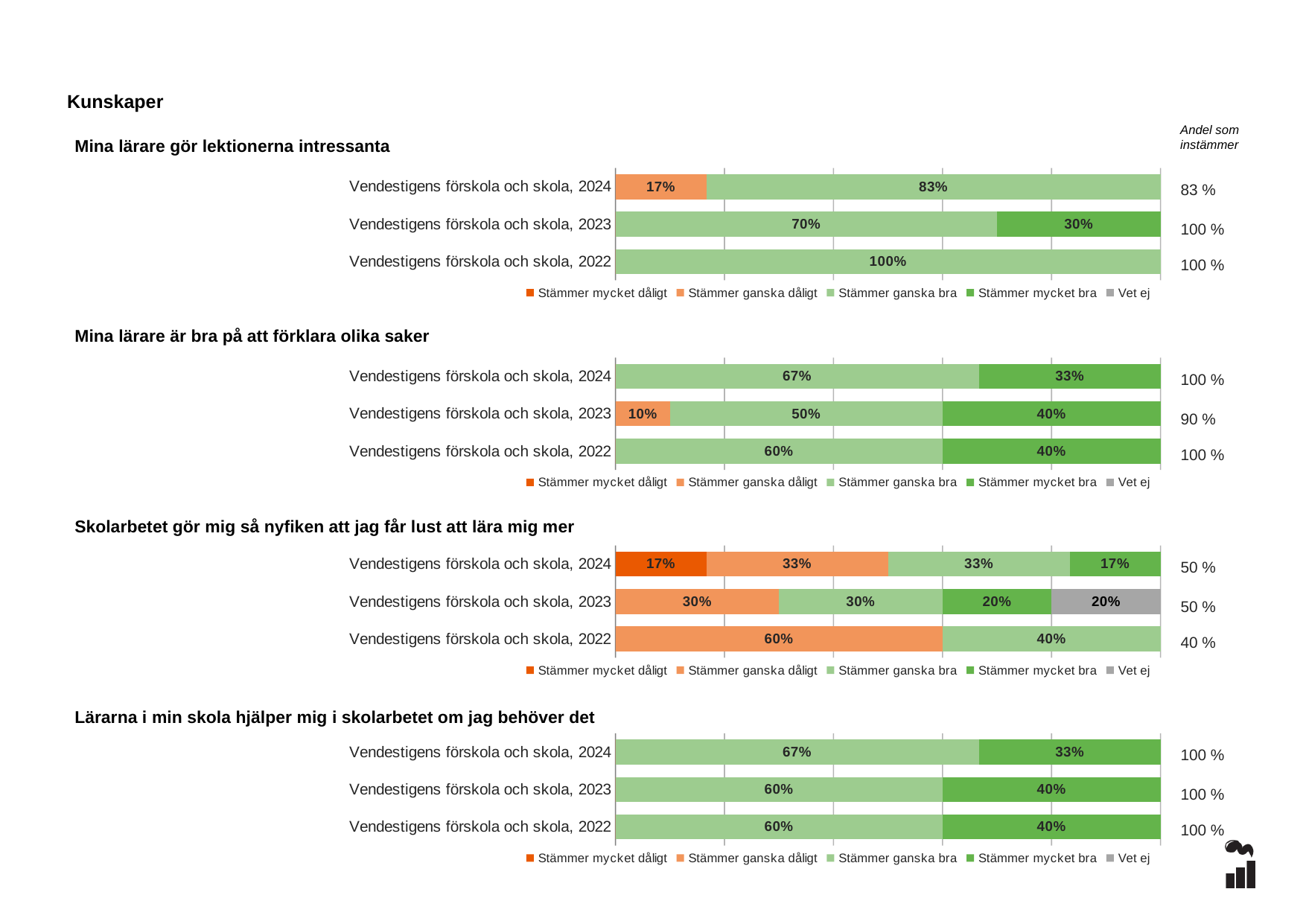
In the chart 'Skolarbetet gör mig så nyfiken att jag får lust att lära mig mer', what is the total of 'Stämmer ganska bra' and 'Stämmer mycket bra' for Vendestigens förskola och skola, 2024? 50% In the chart 'Skolarbetet gör mig så nyfiken att jag får lust att lära mig mer', what is the value of 'Stämmer mycket dåligt' for Vendestigens förskola och skola, 2024? 17% In the chart 'Mina lärare gör lektionerna intressanta', what is the value of 'Stämmer mycket bra' for Vendestigens förskola och skola, 2023? 30% In the chart 'Mina lärare är bra på att förklara olika saker', which is larger for Vendestigens förskola och skola, 2022: 'Stämmer ganska bra' or 'Stämmer mycket bra'? Stämmer ganska bra In the chart 'Skolarbetet gör mig så nyfiken att jag får lust att lära mig mer', what is the value of 'Vet ej' for Vendestigens förskola och skola, 2023? 20% How many series does the legend list in the chart 'Mina lärare gör lektionerna intressanta'? 5 In the chart 'Mina lärare gör lektionerna intressanta', what is the value of 'Stämmer ganska dåligt' for Vendestigens förskola och skola, 2024? 17% How many categories (bars) are shown in the chart 'Lärarna i min skola hjälper mig i skolarbetet om jag behöver det'? 3 In the chart 'Mina lärare är bra på att förklara olika saker', what is the value of 'Stämmer ganska dåligt' for Vendestigens förskola och skola, 2023? 10% In the chart 'Lärarna i min skola hjälper mig i skolarbetet om jag behöver det', what is the difference between 'Stämmer ganska bra' and 'Stämmer mycket bra' for Vendestigens förskola och skola, 2024? 34% In the chart 'Skolarbetet gör mig så nyfiken att jag får lust att lära mig mer', which year has the highest value for 'Stämmer ganska dåligt'? Vendestigens förskola och skola, 2022 What kind of chart is 'Skolarbetet gör mig så nyfiken att jag får lust att lära mig mer'? Stacked bar chart